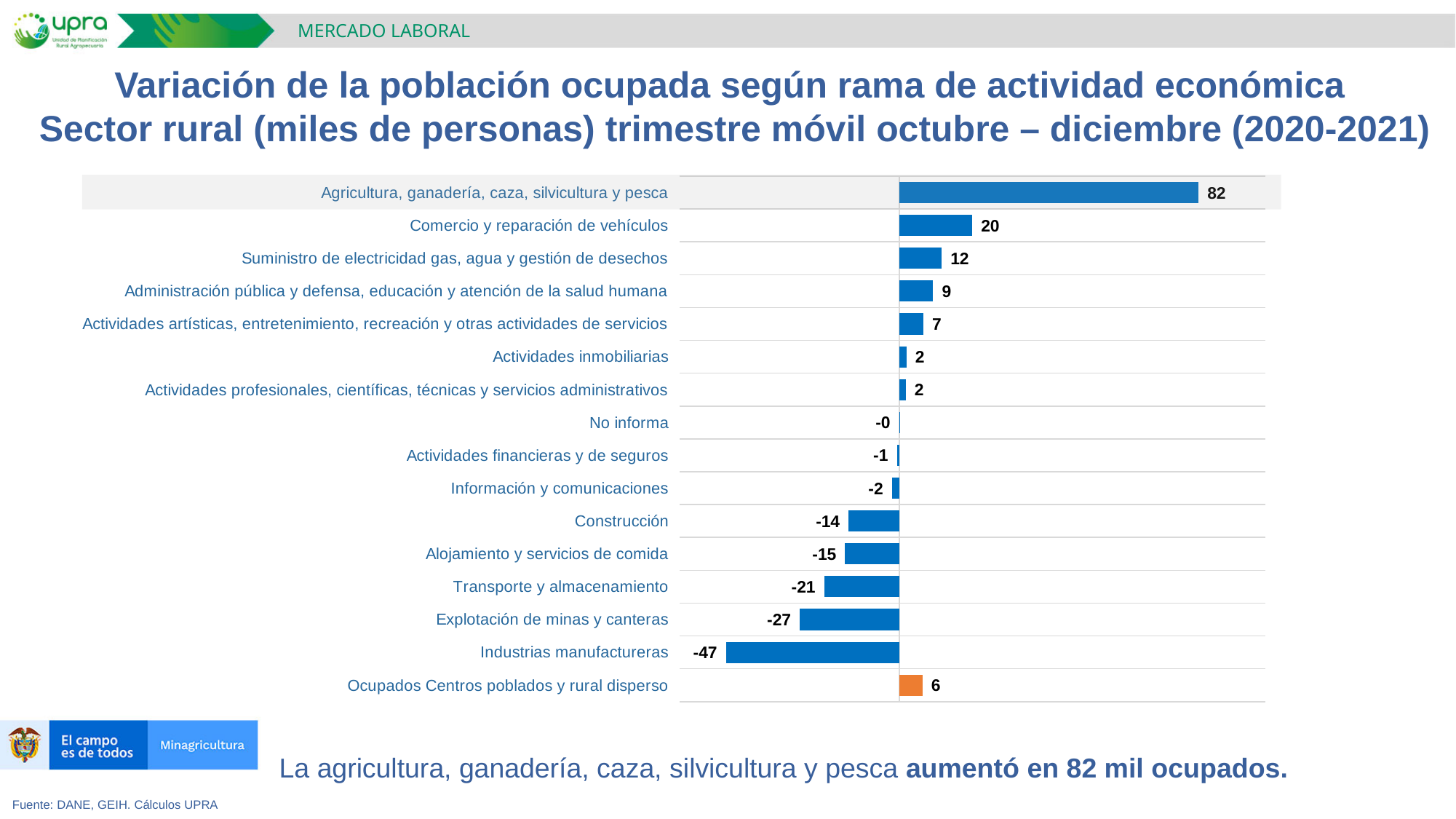
Which is larger, the value for Construcción or the value for Transporte y almacenamiento? Construcción What is the value for Ocupados Centros poblados y rural disperso? 6 Which category has the lowest value? Industrias manufactureras What is the value for Industrias manufactureras? -47 What kind of chart is shown on the slide? Bar chart Which category has the highest value? Agricultura, ganadería, caza, silvicultura y pesca What is the value for Comercio y reparación de vehículos? 20 What is the difference between the values for Comercio y reparación de vehículos and Suministro de electricidad gas, agua y gestión de desechos? 8 What is the value for Explotación de minas y canteras? -27 What is the value for Agricultura, ganadería, caza, silvicultura y pesca? 82 Which bar is shown in orange rather than blue? Ocupados Centros poblados y rural disperso How many categories are shown in the chart? 16